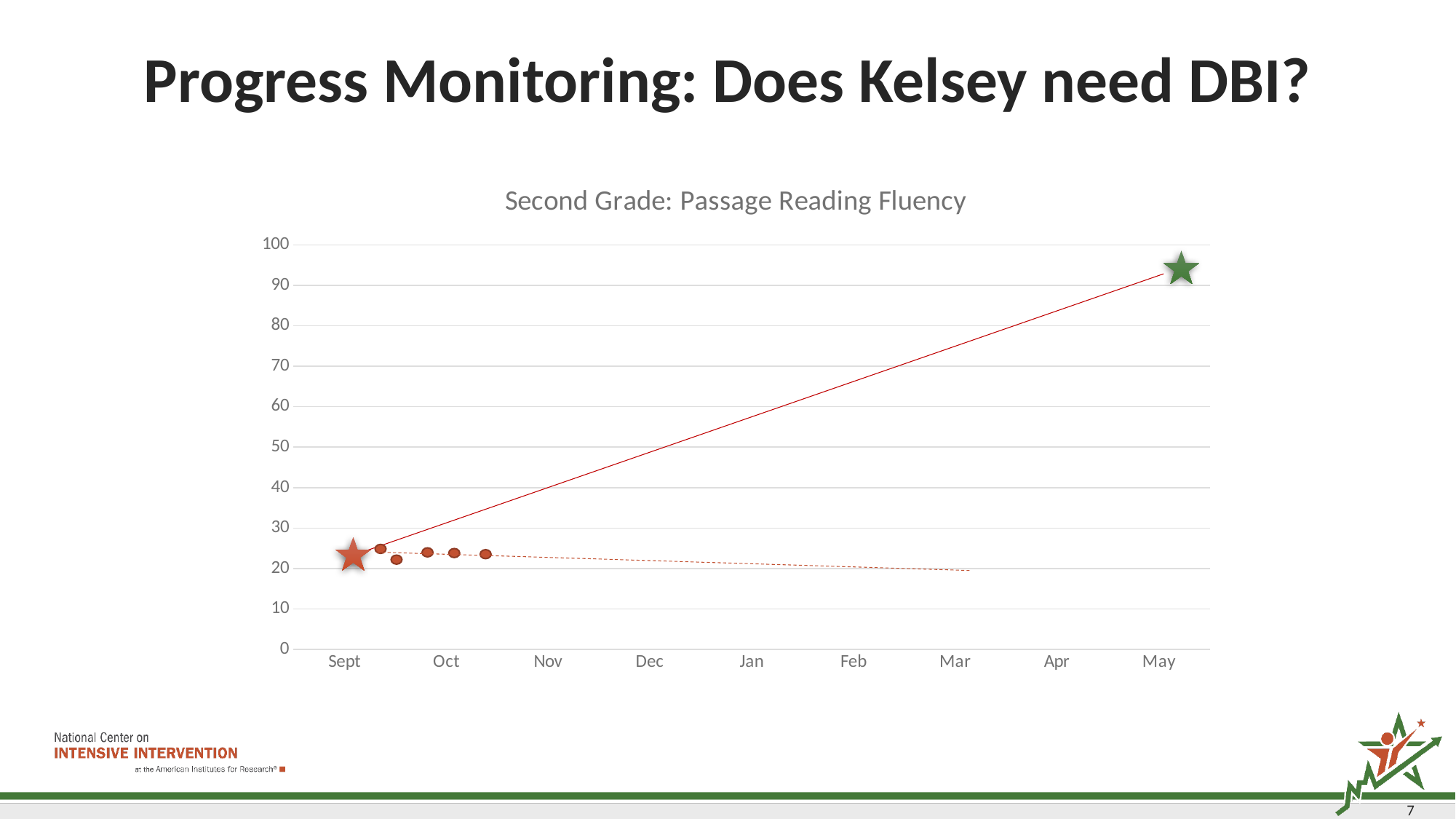
Are the red dot data points between Sept and Oct greater or less than 40? less Does the solid red goal line rise or fall from Sept to May? rise Is the value of the red star marker in Sept greater or less than 30? less What is the title of the chart? Second Grade: Passage Reading Fluency Is the value of the green star goal marker in May greater or less than 50? greater Which is larger, the value of the green star in May or the value of the red star in Sept? the green star in May Which month is the first label on the x axis? Sept What is the highest value shown on the y axis of the chart? 100 How many months are labelled along the x axis of the chart? 9 What kind of chart is shown on the slide? line chart Does the dashed trend line through the red data points rise or fall as it moves toward Mar? fall